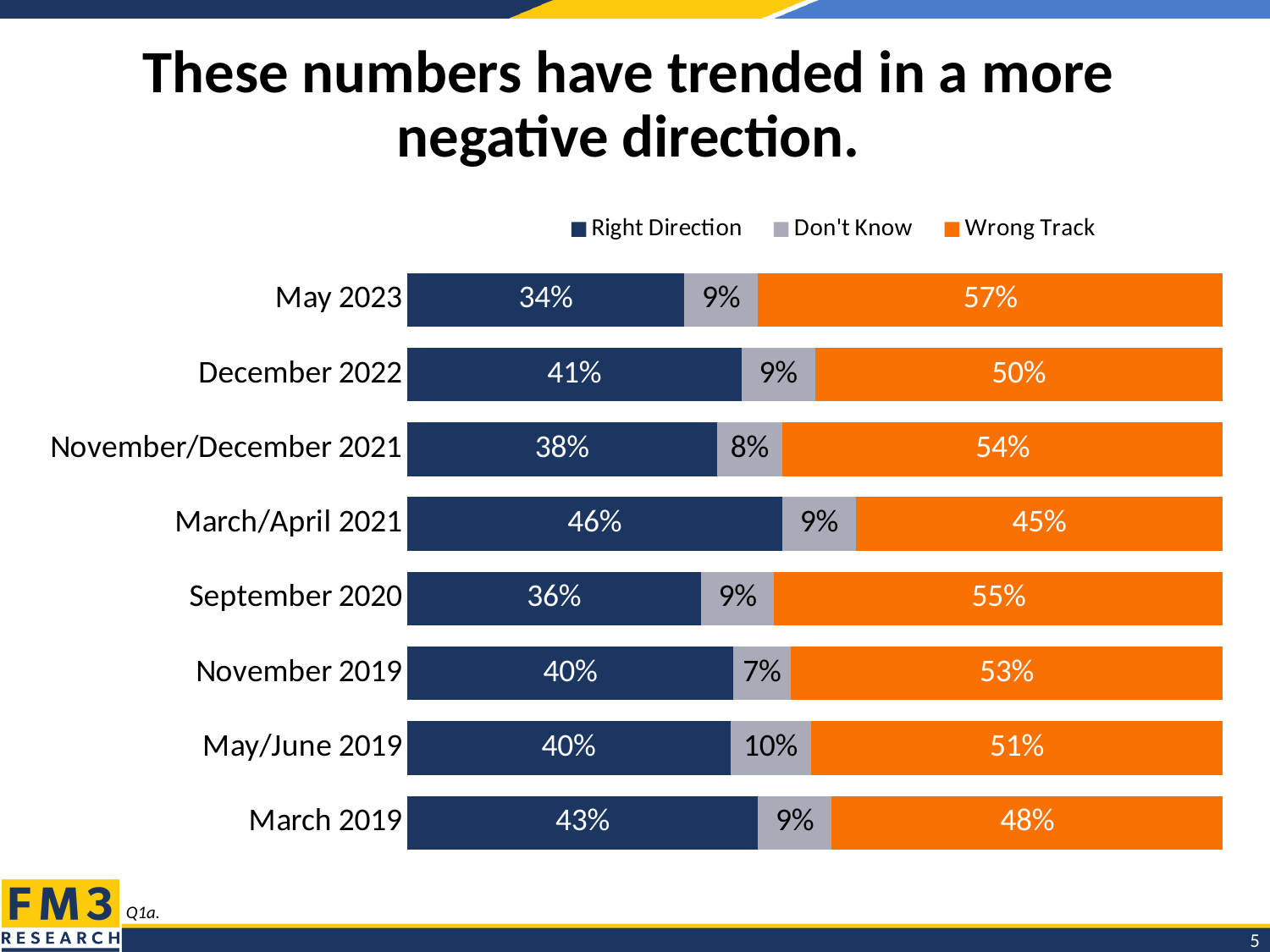
What is the total of the three segments for the November 2019 bar? 100% Which survey period has the highest Wrong Track percentage? May 2023 Which is larger in December 2022, Right Direction or Wrong Track? Wrong Track What percentage said Wrong Track in March/April 2021? 45% How many series does the legend list? 3 Which colour represents Wrong Track in the chart? Orange Which survey period has the lowest Right Direction percentage? May 2023 What is the difference between the Wrong Track and Right Direction percentages in May 2023? 23% How many survey periods are shown on the chart? 8 What percentage said Right Direction in May 2023? 34% What is the Don't Know value for May/June 2019? 10% What kind of chart is shown on the slide? Stacked bar chart